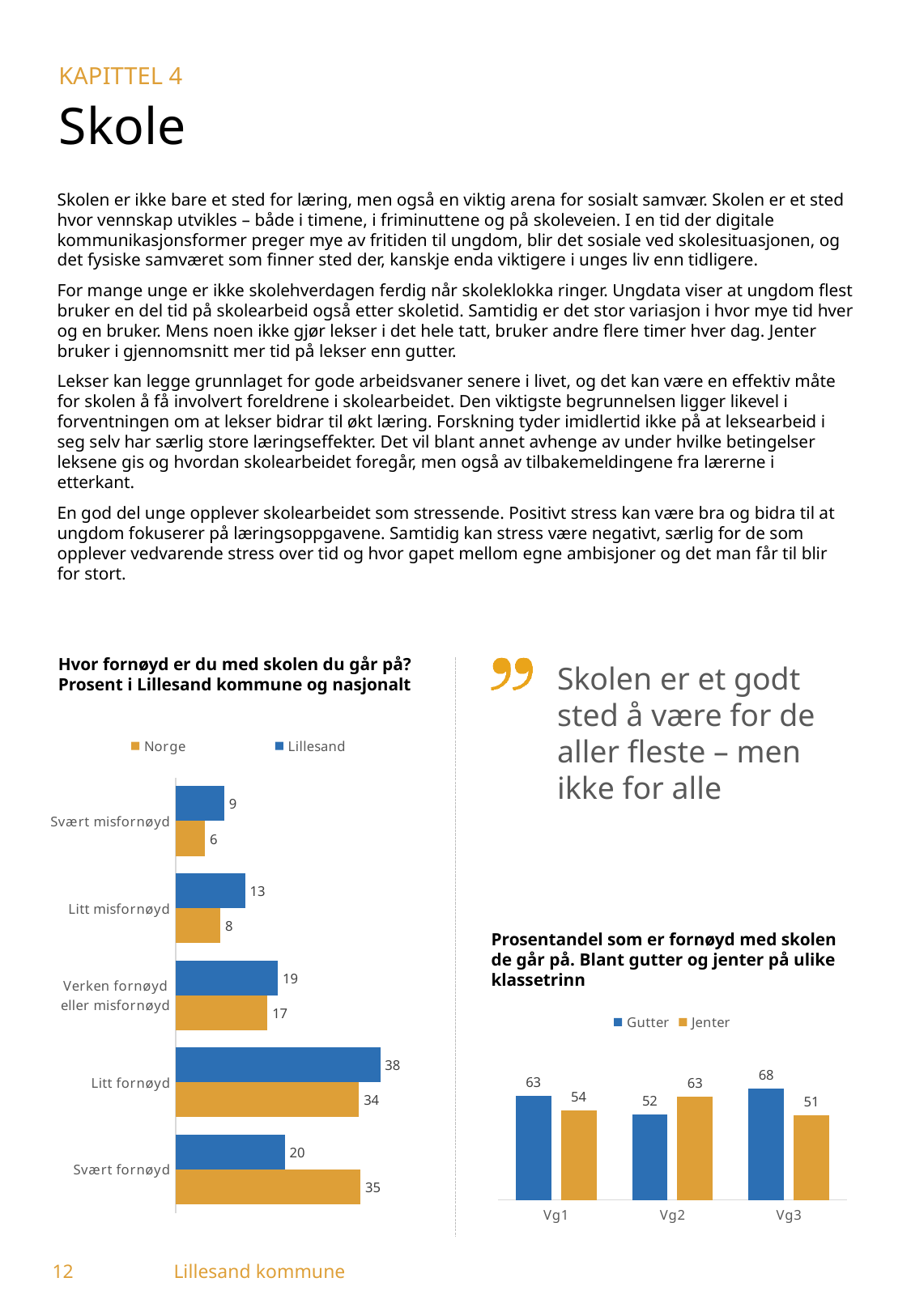
In the chart 'Hvor fornøyd er du med skolen du går på?', which category has the lowest value for Norge? Svært misfornøyd In the chart 'Prosentandel som er fornøyd med skolen de går på', which class level has the highest value for Gutter? Vg3 In the chart 'Hvor fornøyd er du med skolen du går på?', which category has the highest value for Lillesand? Litt fornøyd What kind of chart is 'Prosentandel som er fornøyd med skolen de går på'? Bar chart In the chart 'Hvor fornøyd er du med skolen du går på?', what is the value for Norge in the category 'Svært fornøyd'? 35 In the chart 'Hvor fornøyd er du med skolen du går på?', what is the value for Lillesand in the category 'Litt fornøyd'? 38 In the chart 'Prosentandel som er fornøyd med skolen de går på', what is the value for Jenter at Vg2? 63 In the chart 'Prosentandel som er fornøyd med skolen de går på', which is larger at Vg1, Gutter or Jenter? Gutter In the chart 'Hvor fornøyd er du med skolen du går på?', how many categories are shown? 5 In the chart 'Hvor fornøyd er du med skolen du går på?', how many series does the legend list? 2 In the chart 'Prosentandel som er fornøyd med skolen de går på', what is the difference between Gutter and Jenter at Vg3? 17 In the chart 'Hvor fornøyd er du med skolen du går på?', what is the difference between Norge and Lillesand in the category 'Svært fornøyd'? 15